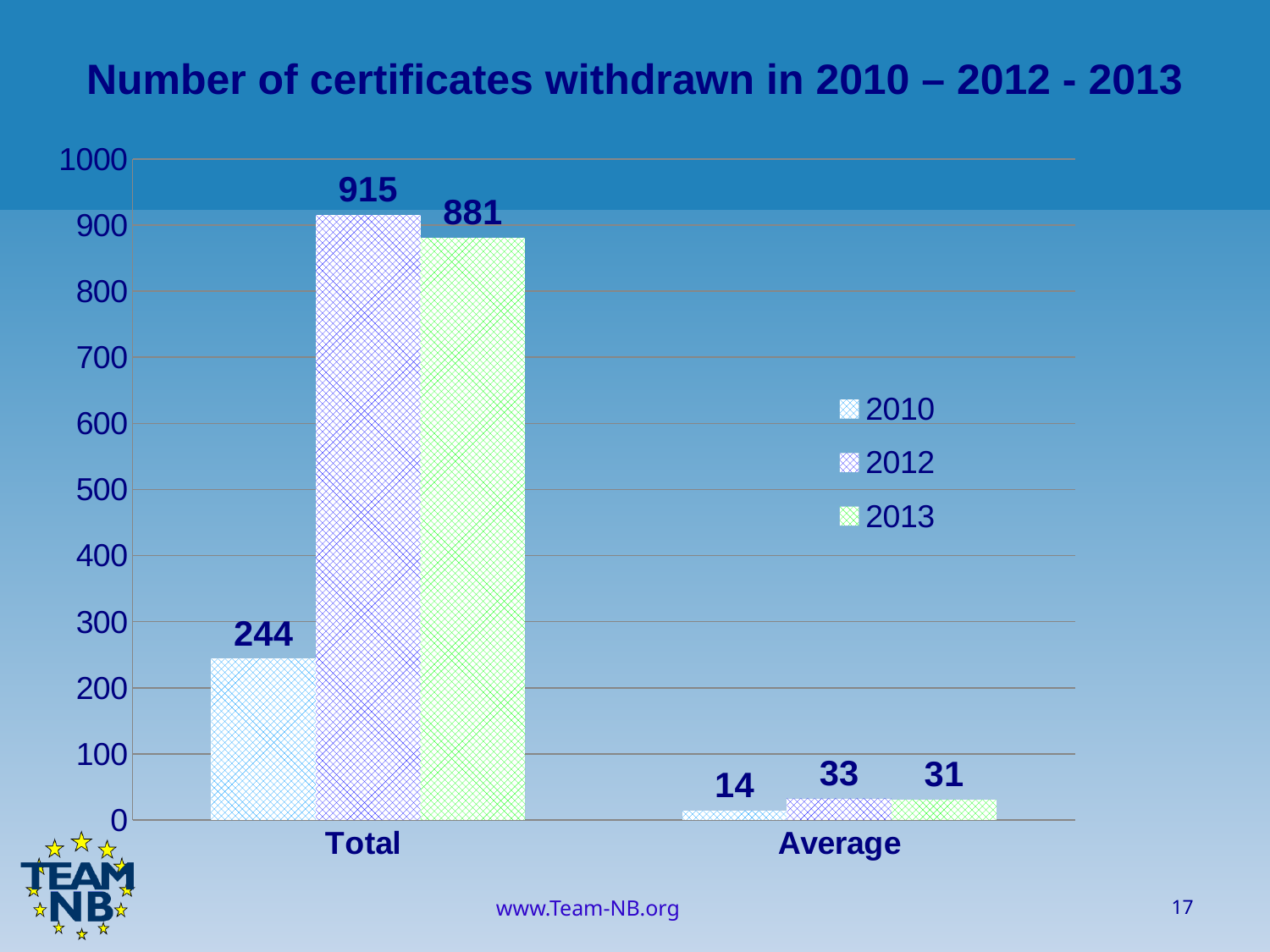
Which year has the lowest Average value? 2010 What is the difference between the Total values for 2012 and 2013? 34 Which year has the highest Total number of certificates withdrawn? 2012 How many series does the legend list? 3 What is the title of the chart? Number of certificates withdrawn in 2010 – 2012 - 2013 Is the Total value for 2010 greater or less than 300? less What is the difference between the Total values for 2013 and 2010? 637 What is the Total value for 2013? 881 What is the Average value for 2010? 14 What is the Total number of certificates withdrawn in 2012? 915 What kind of chart is shown on the slide? bar chart Which is larger, the Average value for 2012 or for 2013? 2012